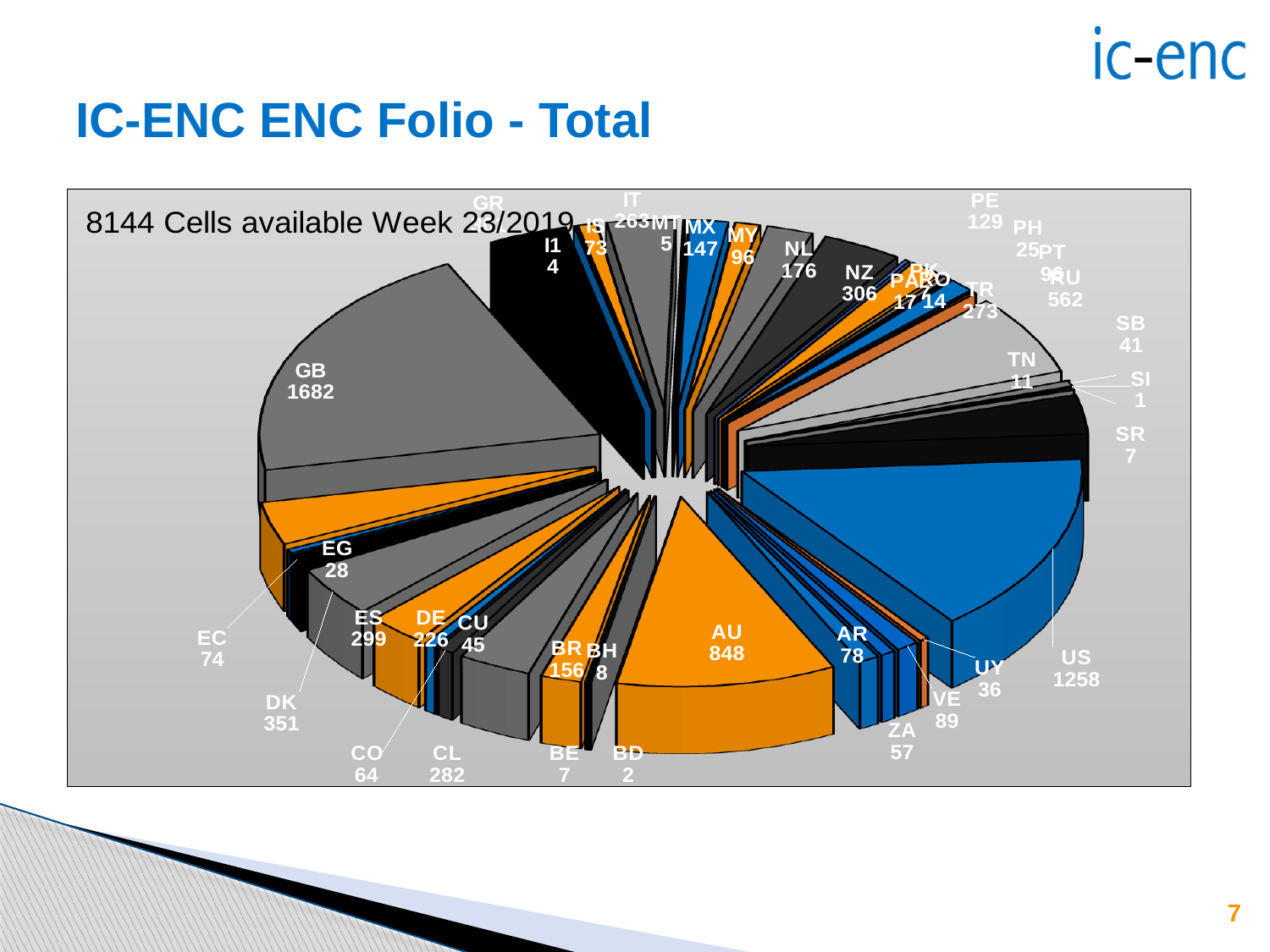
What kind of chart is shown on the slide? Pie chart What is the value shown for RU? 562 What total number of cells does the text inside the chart area state is available for Week 23/2019? 8144 What is the value shown for US? 1258 What is the value shown for DK? 351 Which is larger, the value for DK or the value for NZ? DK How many cells does the GB slice represent? 1682 What is the difference between the US value and the AU value? 410 What is the difference between the GB value and the US value? 424 Which slice has the largest value? GB Which slice has the smallest value? SI What is the value shown for AU? 848